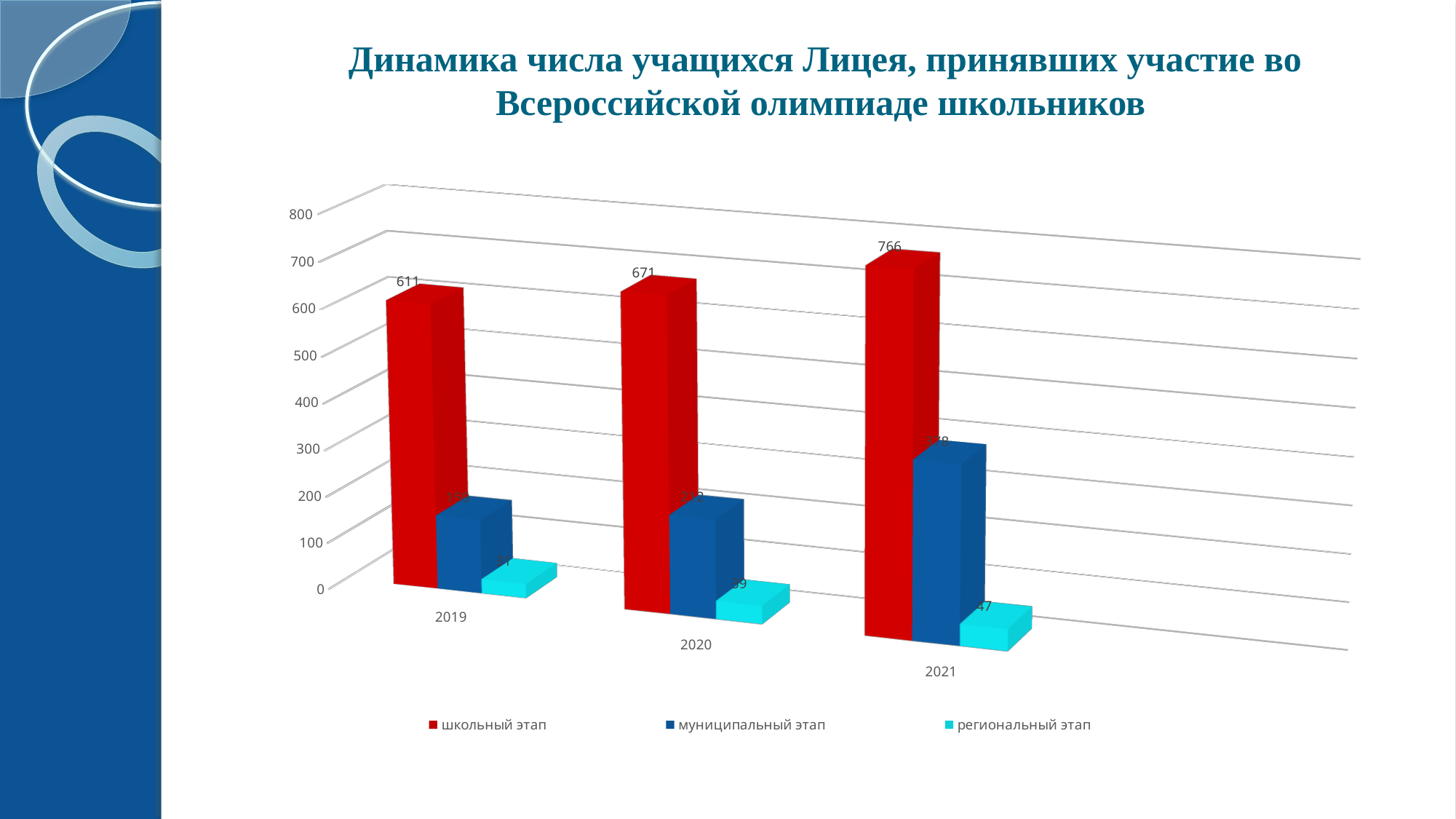
What kind of chart is shown on the slide? bar chart Is the value for муниципальный этап in 2021 greater or less than 200? greater In which year is the value for школьный этап the highest? 2021 What is the value for школьный этап in 2020? 671 Which is larger: the школьный этап value for 2020 or for 2021? 2021 What is the value for школьный этап in 2019? 611 How many years are shown on the x axis? 3 How many series does the legend list? 3 In which year is the value for школьный этап the lowest? 2019 What is the value for школьный этап in 2021? 766 What is the difference between the школьный этап values for 2021 and 2019? 155 Do the values for школьный этап rise or fall from 2019 to 2021? rise